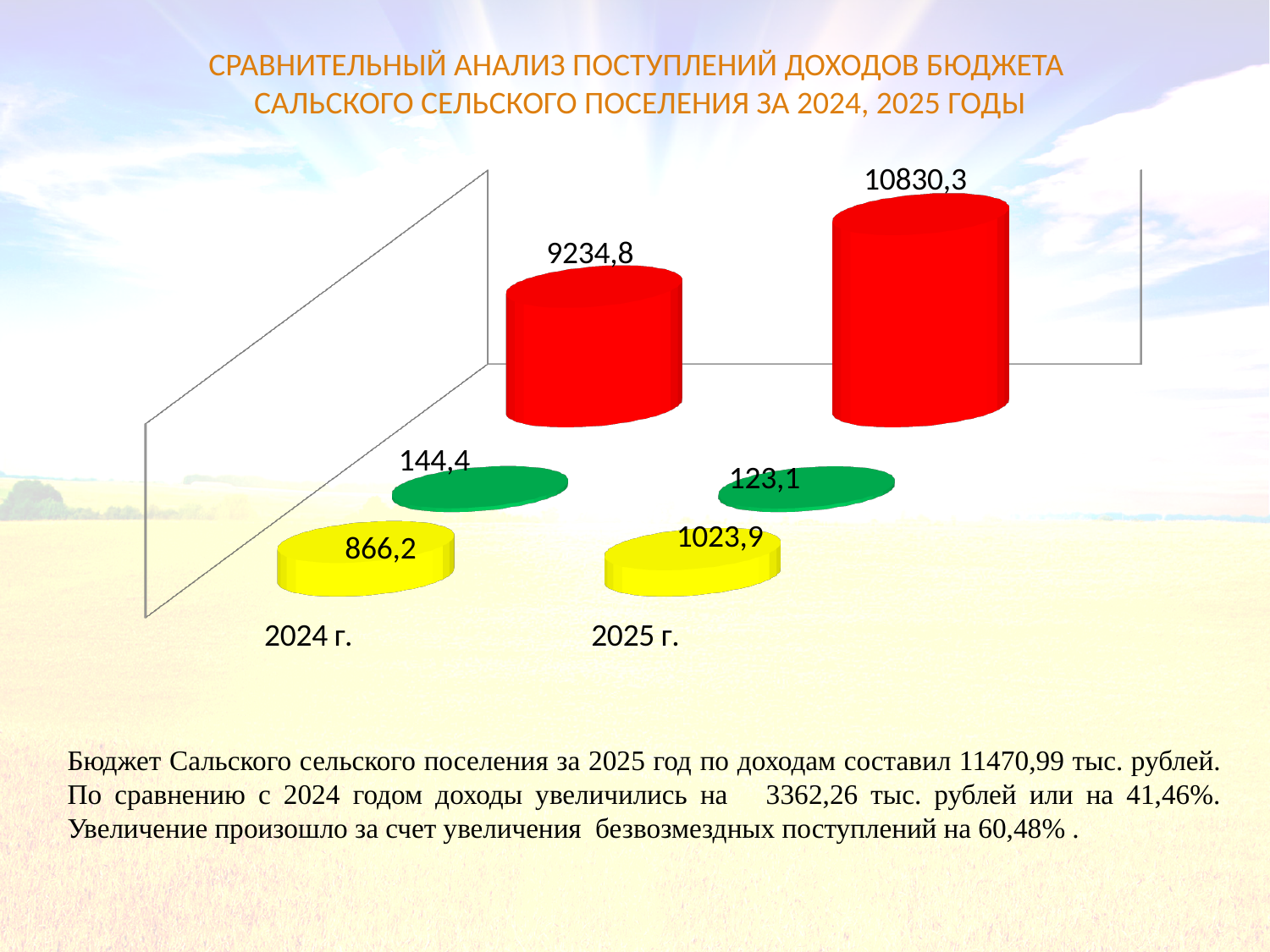
Which bar has the highest value on the chart? Red bar for 2025 г. (10830,3) How many year categories are shown on the chart? 2 What is the value of the yellow bar for 2024 г.? 866,2 By how much does the red series value for 2025 г. exceed that for 2024 г.? 1595,5 Which bar has the lowest value on the chart? Green bar for 2025 г. (123,1) What type of chart is shown on the slide? Bar chart Which year has the higher value for the green series, 2024 г. or 2025 г.? 2024 г. What is the value of the green bar for 2025 г.? 123,1 What is the value of the red bar for 2025 г.? 10830,3 Does the red series rise or fall from 2024 г. to 2025 г.? Rises What is the value of the red bar for 2024 г.? 9234,8 What is the difference between the yellow series values for 2025 г. and 2024 г.? 157,7